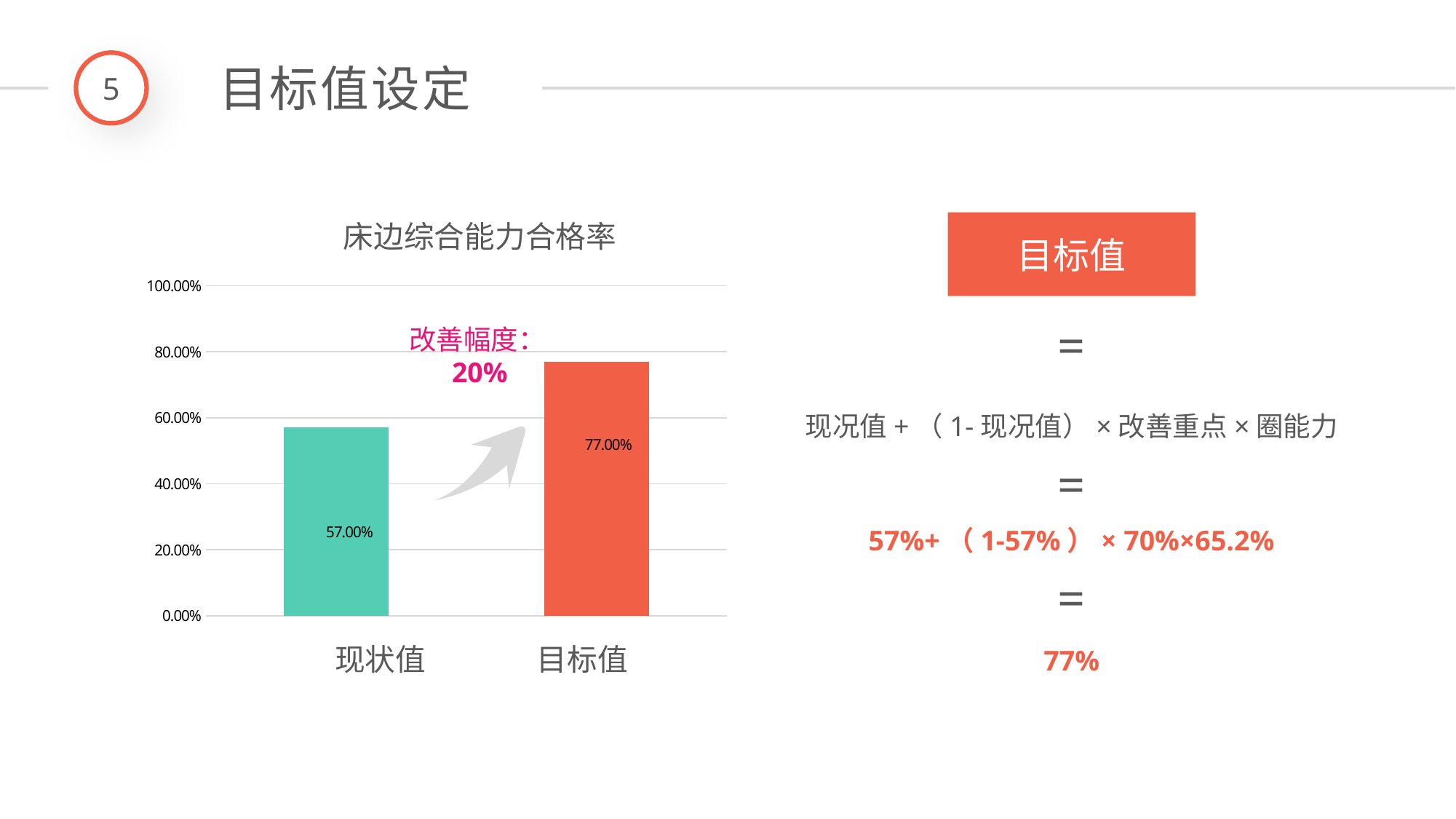
Which category has the highest value in the chart? 目标值 Which category has the lowest value in the chart? 现状值 Which category has the higher value, 现状值 or 目标值? 目标值 Is the value for 现状值 greater or less than 60.00%? less How many categories are shown in the chart? 2 What is the difference between the values for 目标值 and 现状值? 20.00% Is the value for 目标值 greater or less than 60.00%? greater What improvement margin (改善幅度) is annotated on the chart? 20% What is the value for 现状值 in the chart? 57.00% What is the title of the chart? 床边综合能力合格率 What kind of chart is shown on the slide? bar chart What is the value for 目标值 in the chart? 77.00%